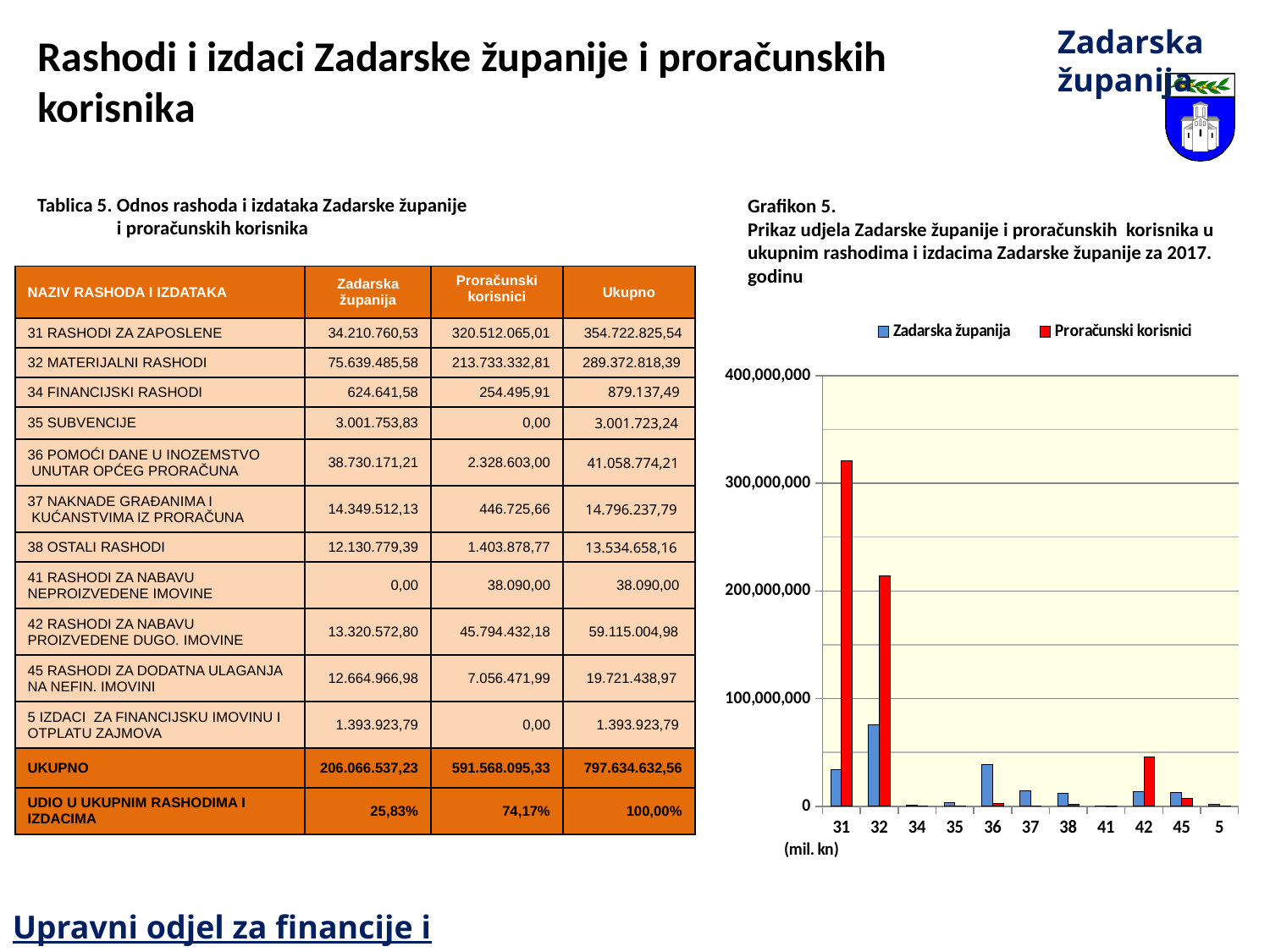
What kind of chart is Grafikon 5? bar chart How many categories are shown on the x axis of Grafikon 5? 11 What unit label is shown below the x axis of Grafikon 5? (mil. kn) In Grafikon 5, for category 36, which series has the larger value: Zadarska županija or Proračunski korisnici? Zadarska županija In Grafikon 5, is the Zadarska županija value for category 32 greater or less than 100,000,000? less In Grafikon 5, is the Proračunski korisnici value for category 31 greater or less than 300,000,000? greater In Grafikon 5, is the Proračunski korisnici value for category 32 greater or less than 200,000,000? greater In Grafikon 5, which colour represents the Proračunski korisnici series? red In Grafikon 5, which category has the highest value for Proračunski korisnici? 31 In Grafikon 5, which category has the highest value for Zadarska županija? 32 How many series does the legend of Grafikon 5 list? 2 In Grafikon 5, for category 31, which series has the larger value: Zadarska županija or Proračunski korisnici? Proračunski korisnici